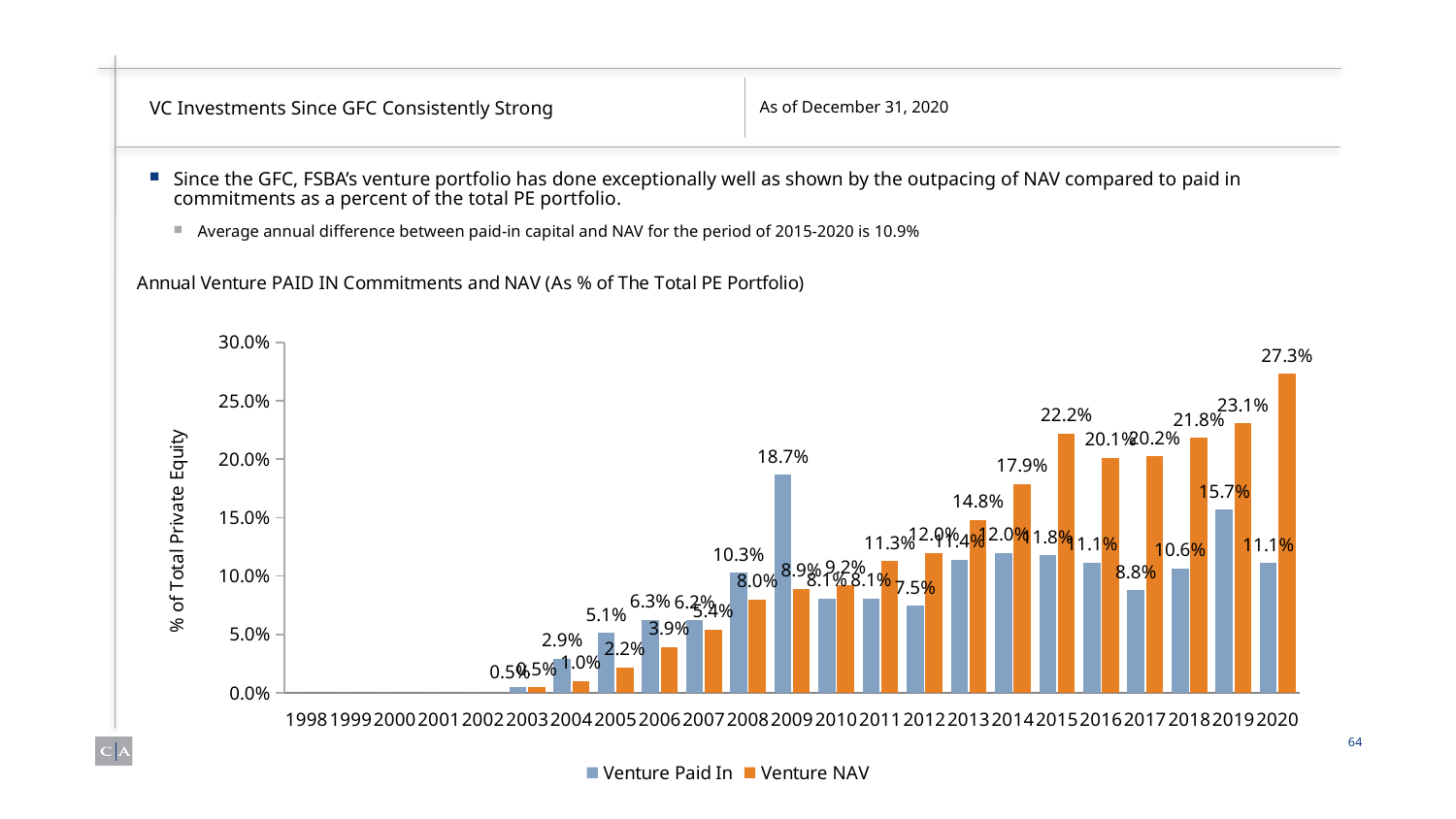
What is the Venture NAV value for 2015? 22.2% What is the Venture NAV value for 2020? 27.3% In which year is Venture NAV highest? 2020 In 2019, which is larger, Venture Paid In or Venture NAV? Venture NAV What is the difference between Venture NAV and Venture Paid In in 2020? 16.2% What is the Venture Paid In value for 2019? 15.7% What is the Venture Paid In value for 2009? 18.7% Is the Venture Paid In value for 2017 greater or less than 10.0%? less What kind of chart is shown on the slide? Bar chart In which year is Venture Paid In highest? 2009 Does Venture NAV rise or fall from 2003 to 2008? Rise How many series does the legend list? 2